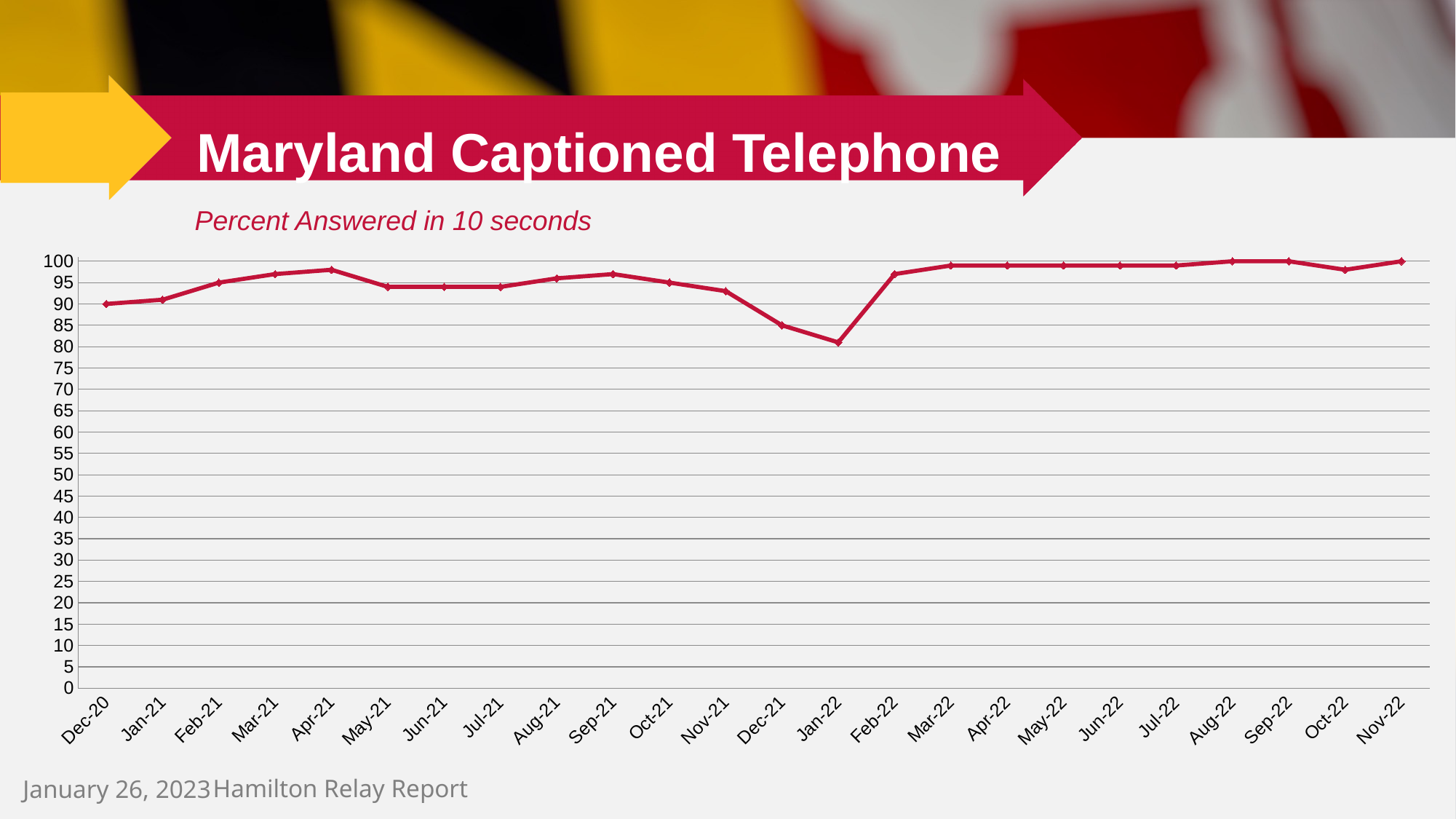
Is the value for Jan-22 greater or less than 85? less Which is higher, the value for Dec-21 or the value for Feb-22? Feb-22 Is the value for Mar-22 greater or less than 95? greater Is the value for Dec-21 greater or less than 80? greater How many months are plotted along the x axis? 24 Does the value rise or fall from Dec-21 to Jan-22? fall What kind of chart is shown on the slide? line chart What is the subtitle of the chart? Percent Answered in 10 seconds Which month has the lowest percent answered in 10 seconds? Jan-22 Which is higher, the value for Apr-21 or the value for May-21? Apr-21